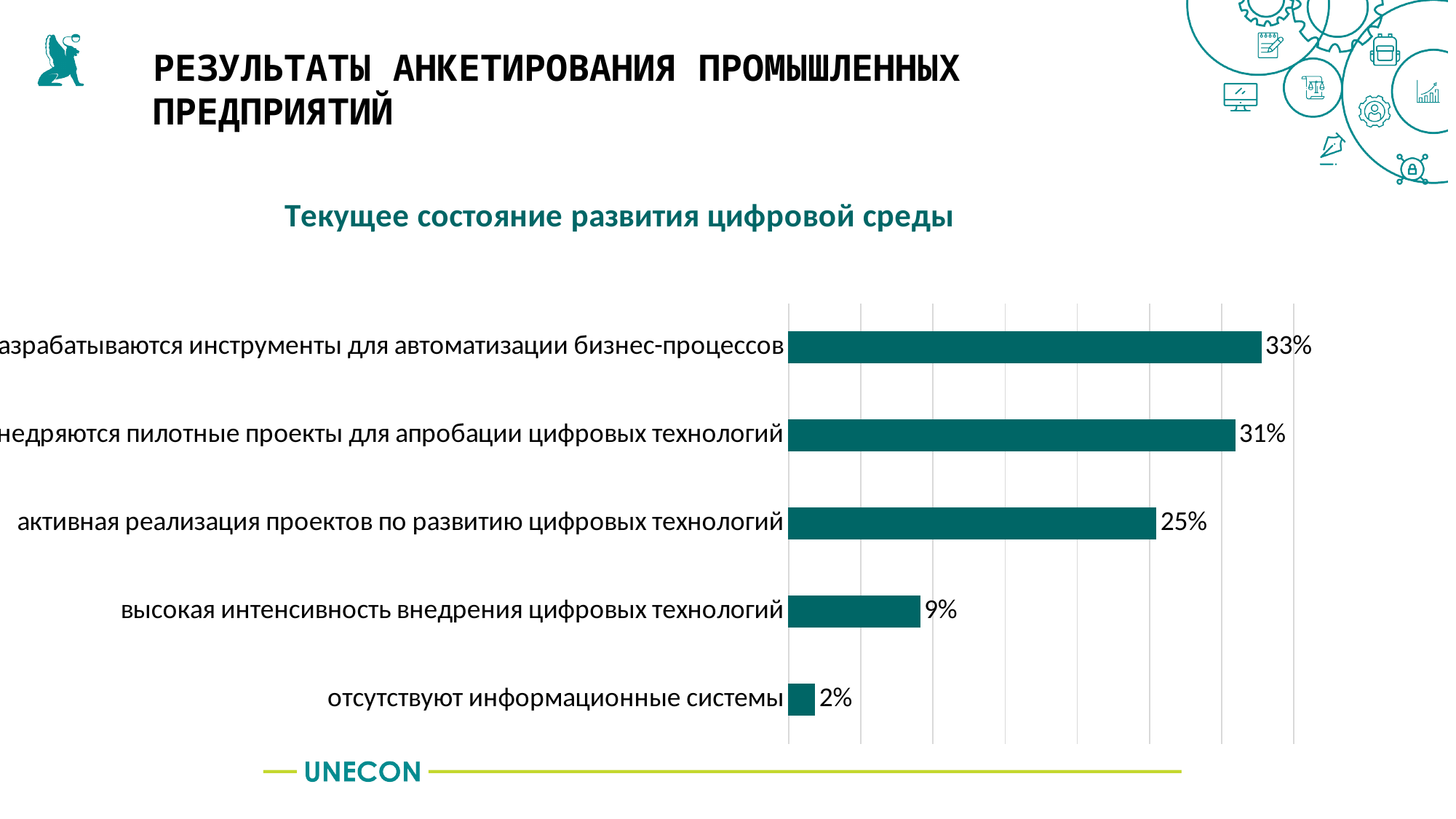
What is the value for "отсутствуют информационные системы"? 2% Which category has the highest value? разрабатываются инструменты для автоматизации бизнес-процессов Which is larger: the value for "высокая интенсивность внедрения цифровых технологий" or for "отсутствуют информационные системы"? высокая интенсивность внедрения цифровых технологий What is the difference between the values for "активная реализация проектов по развитию цифровых технологий" and "высокая интенсивность внедрения цифровых технологий"? 16% What is the value for the category about "пилотные проекты для апробации цифровых технологий"? 31% What is the value for "высокая интенсивность внедрения цифровых технологий"? 9% What is the value for the category about "инструменты для автоматизации бизнес-процессов"? 33% Which category has the lowest value? отсутствуют информационные системы What is the title of the chart? Текущее состояние развития цифровой среды What type of chart is shown on the slide? bar chart What is the value for "активная реализация проектов по развитию цифровых технологий"? 25% How many categories are shown in the chart? 5